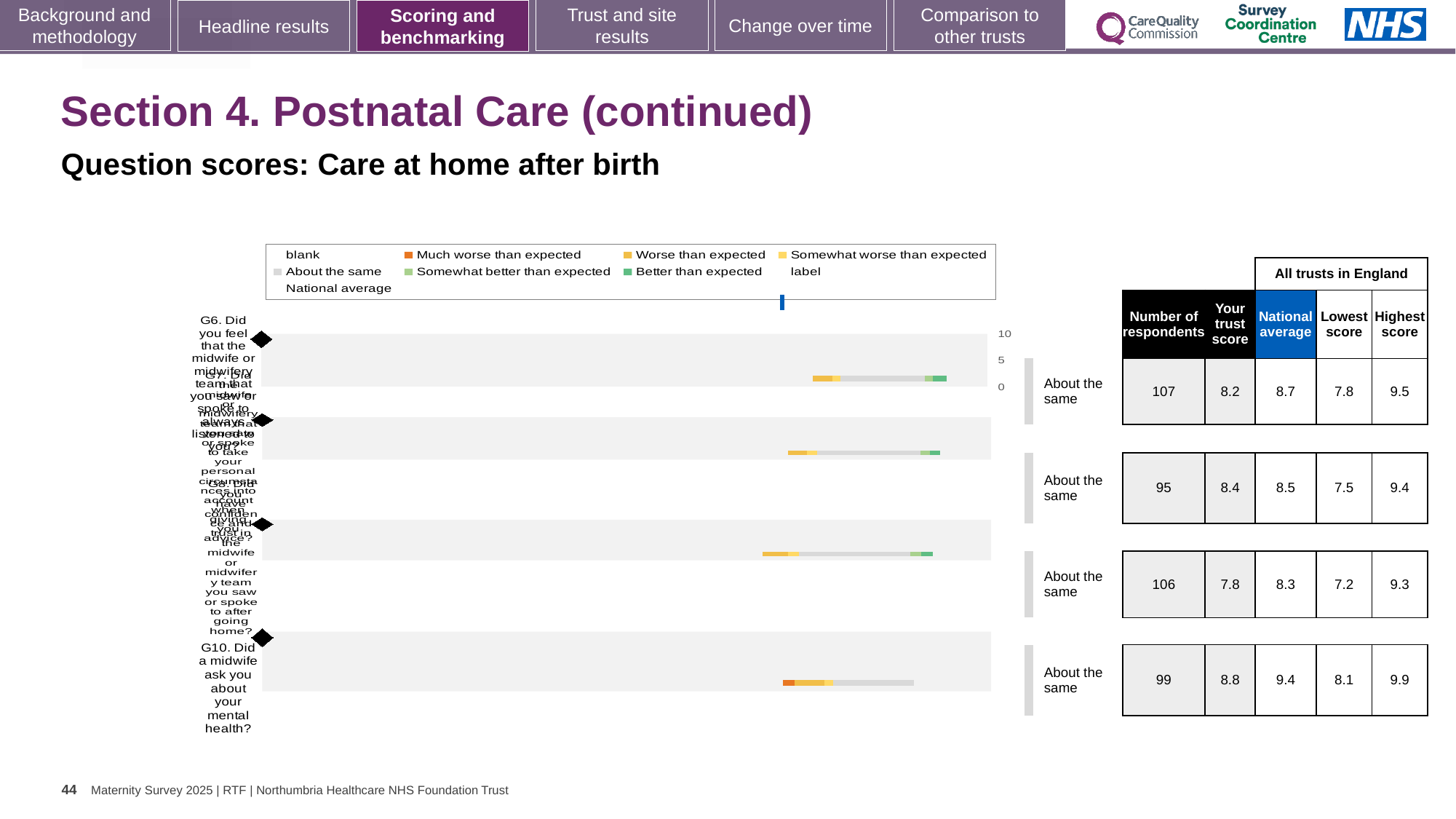
For G10, what is the difference between the national average and the trust score? 0.6 How many question rows (bars) are plotted in the chart? 4 Which question row has the lowest trust score? The third row, 7.8 Which question row has the highest trust score? G10 (mental health), 8.8 What is the highest score among all trusts in England for G10? 9.9 How many respondents answered G10 (Did a midwife ask you about your mental health?)? 99 What is the national average for the first question row (G6)? 8.7 What kind of chart is used to show the question scores for care at home after birth? bar chart What benchmark category is shown for every question row in the chart? About the same For the first question row (G6), which is larger: the trust score or the national average? National average (8.7) What is the lowest score among all trusts in England for the second question row? 7.5 What is the trust score for G10 (Did a midwife ask you about your mental health?)? 8.8